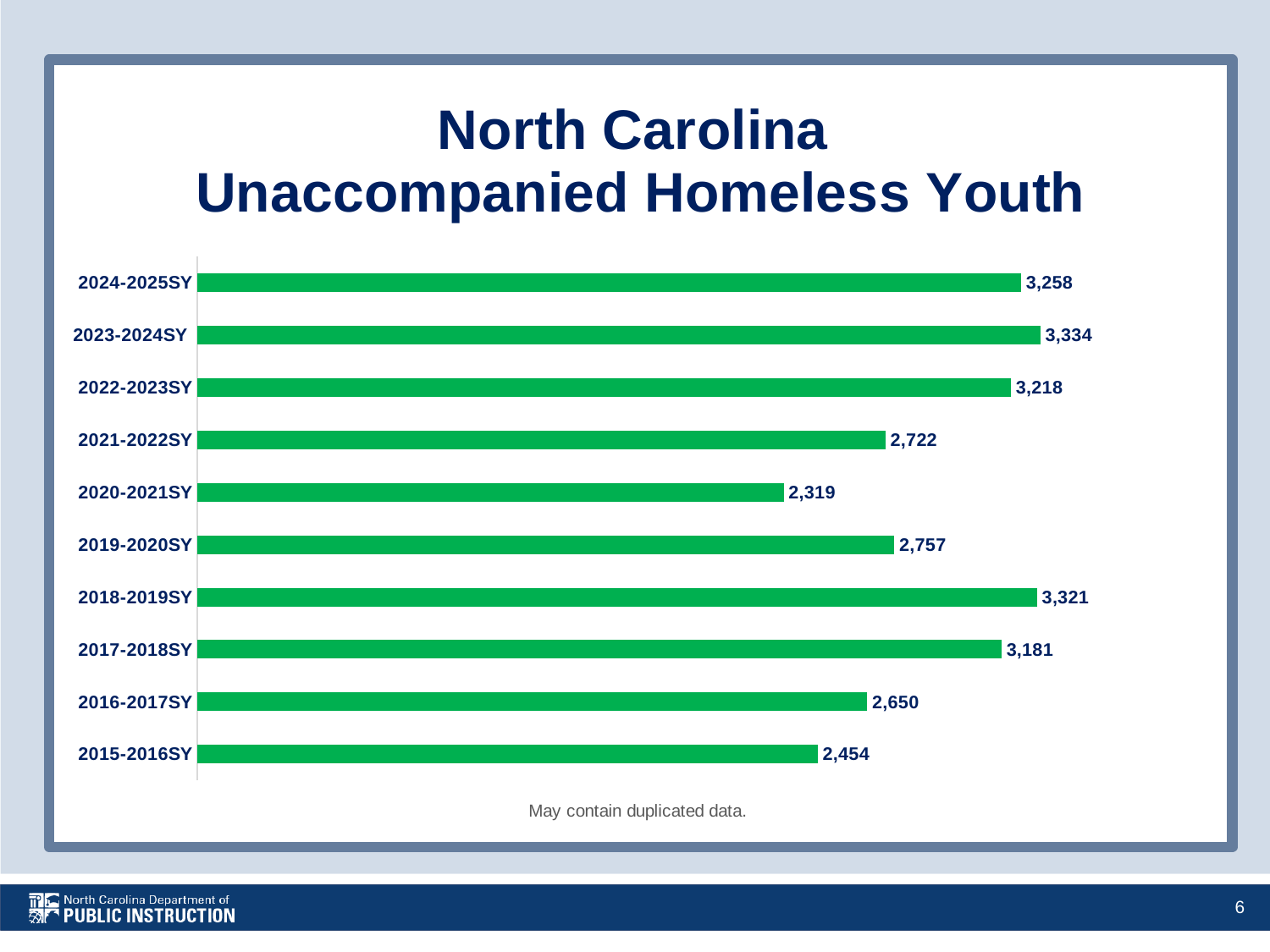
Which school year has the highest value? 2023-2024SY Which is larger, the value for 2018-2019SY or the value for 2017-2018SY? 2018-2019SY What kind of chart is shown on the slide? Bar chart What is the difference between the values for 2023-2024SY and 2024-2025SY? 76 What is the value for 2024-2025SY? 3,258 What is the value for 2020-2021SY? 2,319 How many school years are shown in the chart? 10 Which school year has the lowest value? 2020-2021SY Which is larger, the value for 2016-2017SY or the value for 2019-2020SY? 2019-2020SY What is the value for 2015-2016SY? 2,454 What is the difference between the values for 2021-2022SY and 2020-2021SY? 403 What is the title of the chart? North Carolina Unaccompanied Homeless Youth